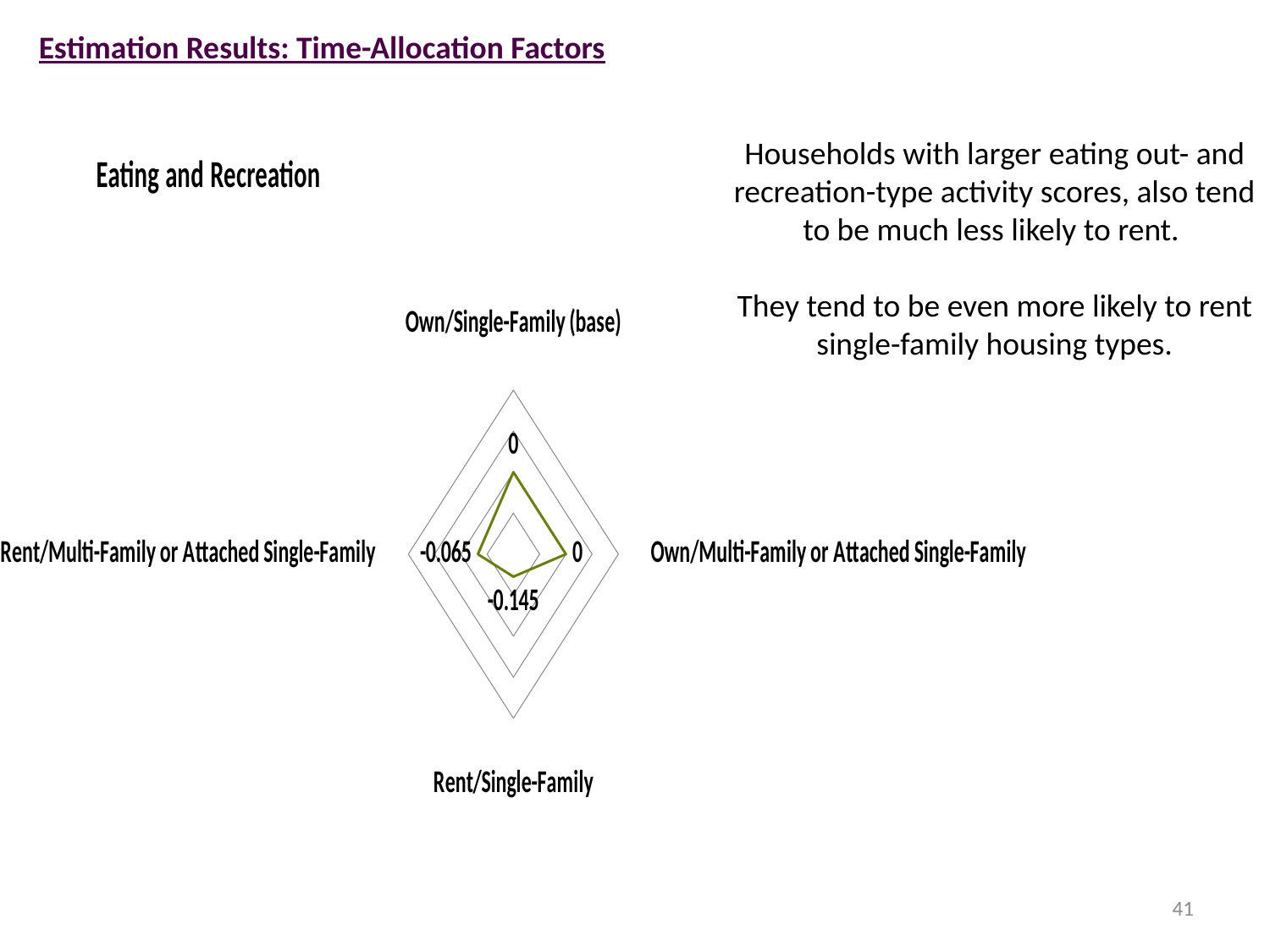
What is the value for Rent/Multi-Family or Attached Single-Family? -0.065 Which category is labelled as the base? Own/Single-Family (base) What is the value for Own/Single-Family (base)? 0 What kind of chart is shown on the slide? Radar chart How many categories have a value of 0? 2 What is the title of the chart? Eating and Recreation What is the value for Own/Multi-Family or Attached Single-Family? 0 What is the difference between the values for Rent/Multi-Family or Attached Single-Family and Rent/Single-Family? 0.08 Which is larger, the value for Rent/Single-Family or the value for Rent/Multi-Family or Attached Single-Family? Rent/Multi-Family or Attached Single-Family Which category has the lowest value? Rent/Single-Family What is the value for Rent/Single-Family? -0.145 How many categories (axes) does the radar chart have? 4